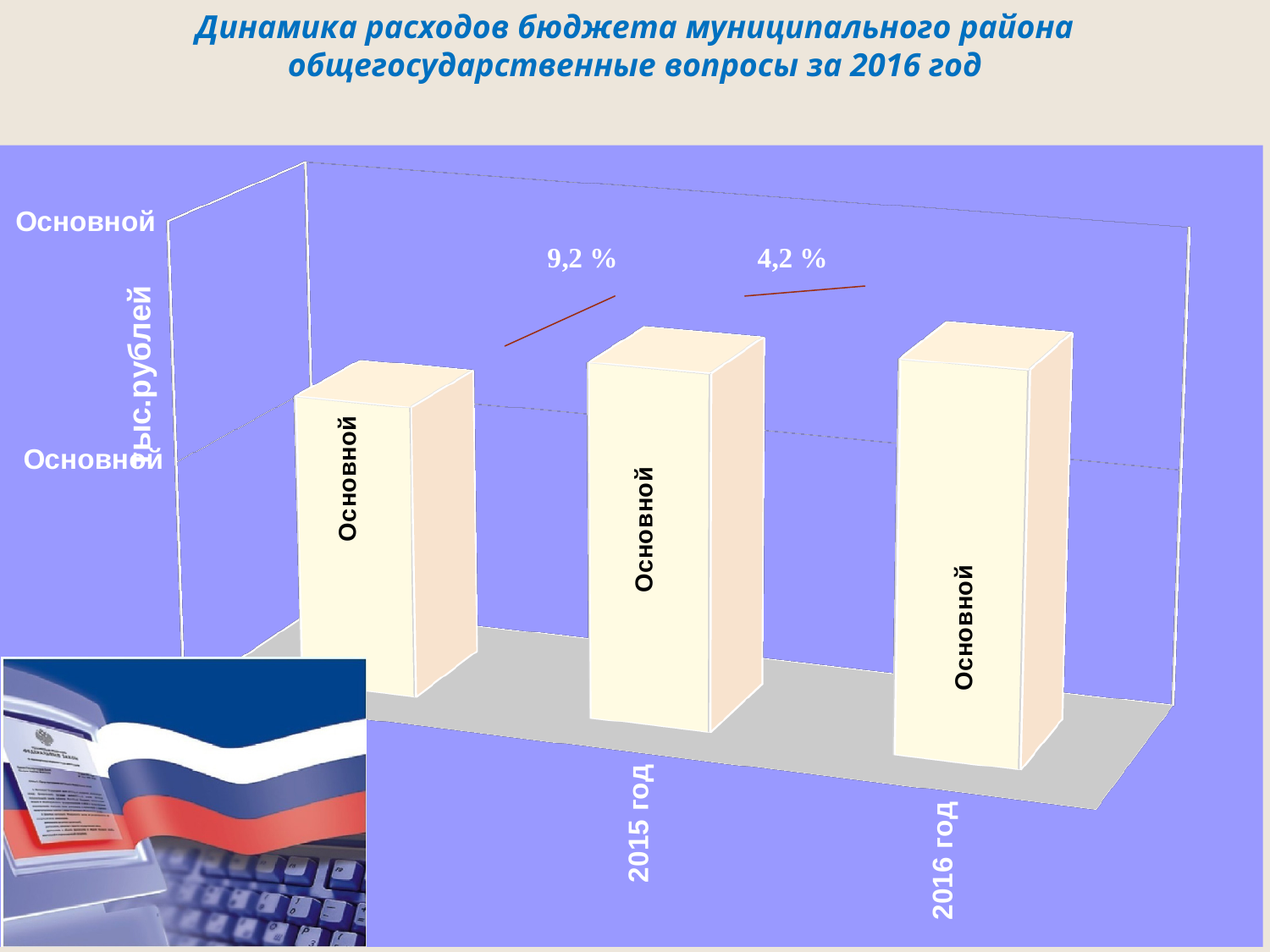
What kind of chart is shown on the slide? bar chart Do the bar values rise or fall from left to right across the chart? rise Which is larger, the bar for 2015 год or the bar for 2016 год? 2016 год What percentage is written above the chart between the 2015 год and 2016 год bars? 4,2 % Which labelled year has the tallest bar in the chart? 2016 год What is the title of the chart on the slide? Динамика расходов бюджета муниципального района общегосударственные вопросы за 2016 год How many bars are plotted in the chart? 3